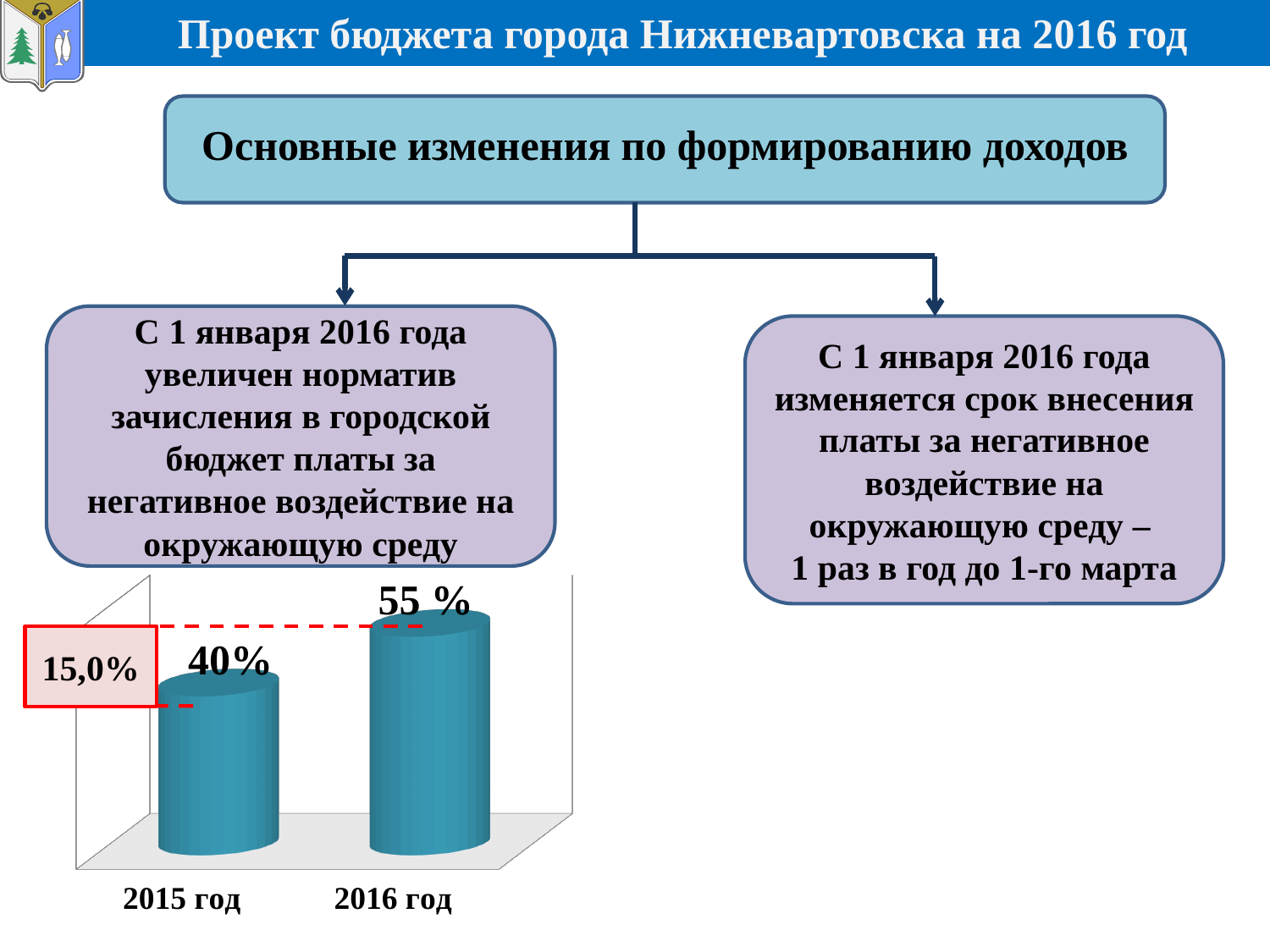
By how many percentage points does the 2016 год value exceed the 2015 год value, as annotated on the chart? 15,0% What is the value shown for 2015 год in the chart? 40% Is the value for 2016 год larger or smaller than the value for 2015 год? larger What value is shown in the red-outlined box next to the chart? 15,0% Do the values rise or fall from 2015 год to 2016 год? rise What colour are the bars in the chart? teal (blue-green) Which year has the higher value in the chart? 2016 год How many categories (years) are plotted in the chart? 2 What kind of chart is shown on the slide? bar chart Which year has the lower value in the chart? 2015 год What is the value shown for 2016 год in the chart? 55 %